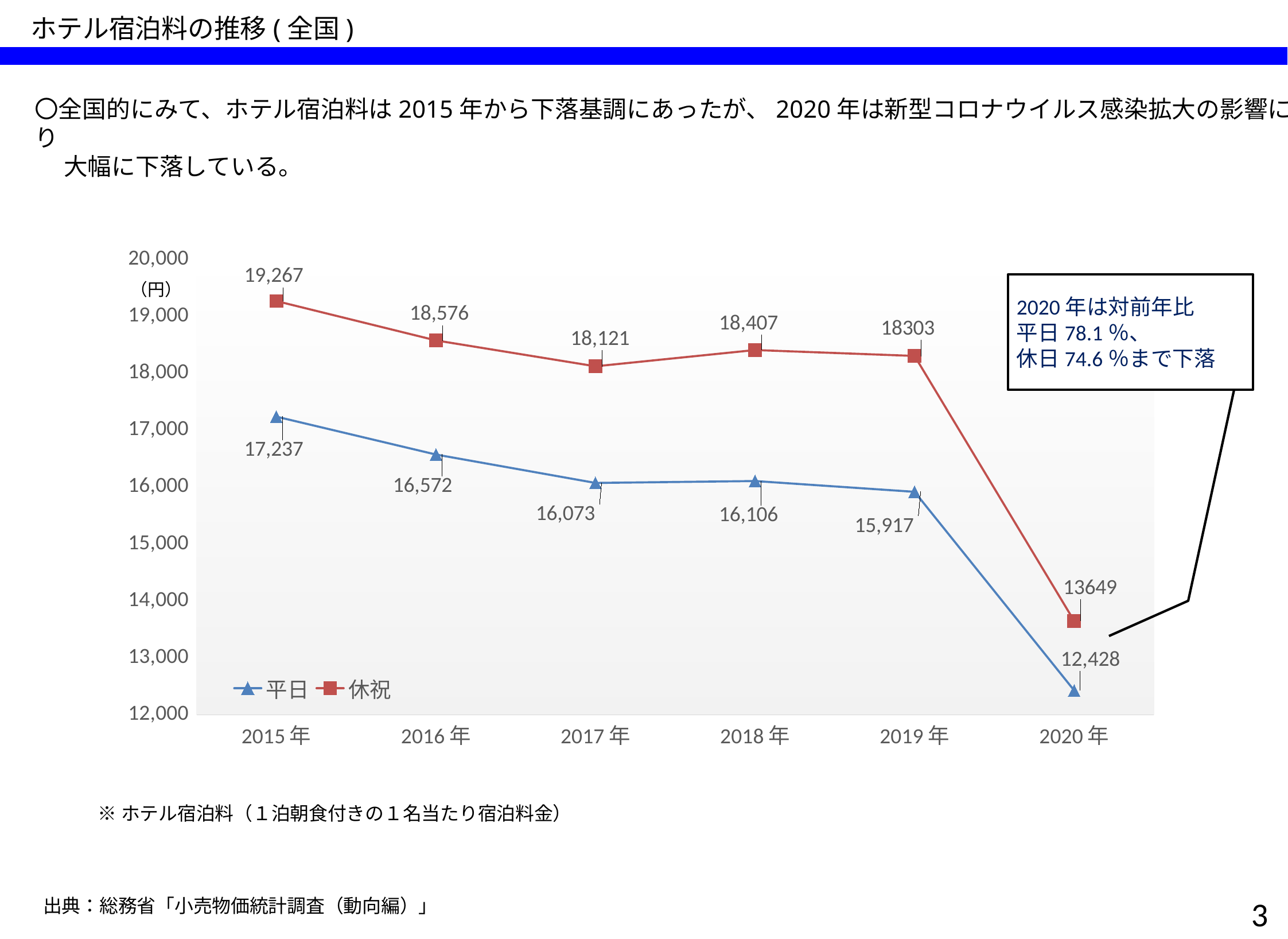
What is the value for 平日 in 2015年? 17,237 What is the difference between the 休祝 and 平日 values in 2015年? 2,030 What is the value for 休祝 in 2020年? 13649 What kind of chart is shown on the slide? line chart How many years are plotted on the x axis? 6 What is the value for 平日 in 2018年? 16,106 In which year is the 平日 value lowest? 2020年 Which is larger in 2017年, the 平日 value or the 休祝 value? 休祝 Does the 平日 series rise or fall from 2019年 to 2020年? fall How many series does the legend list? 2 In which year is the 休祝 value highest? 2015年 What is the value for 休祝 in 2019年? 18303